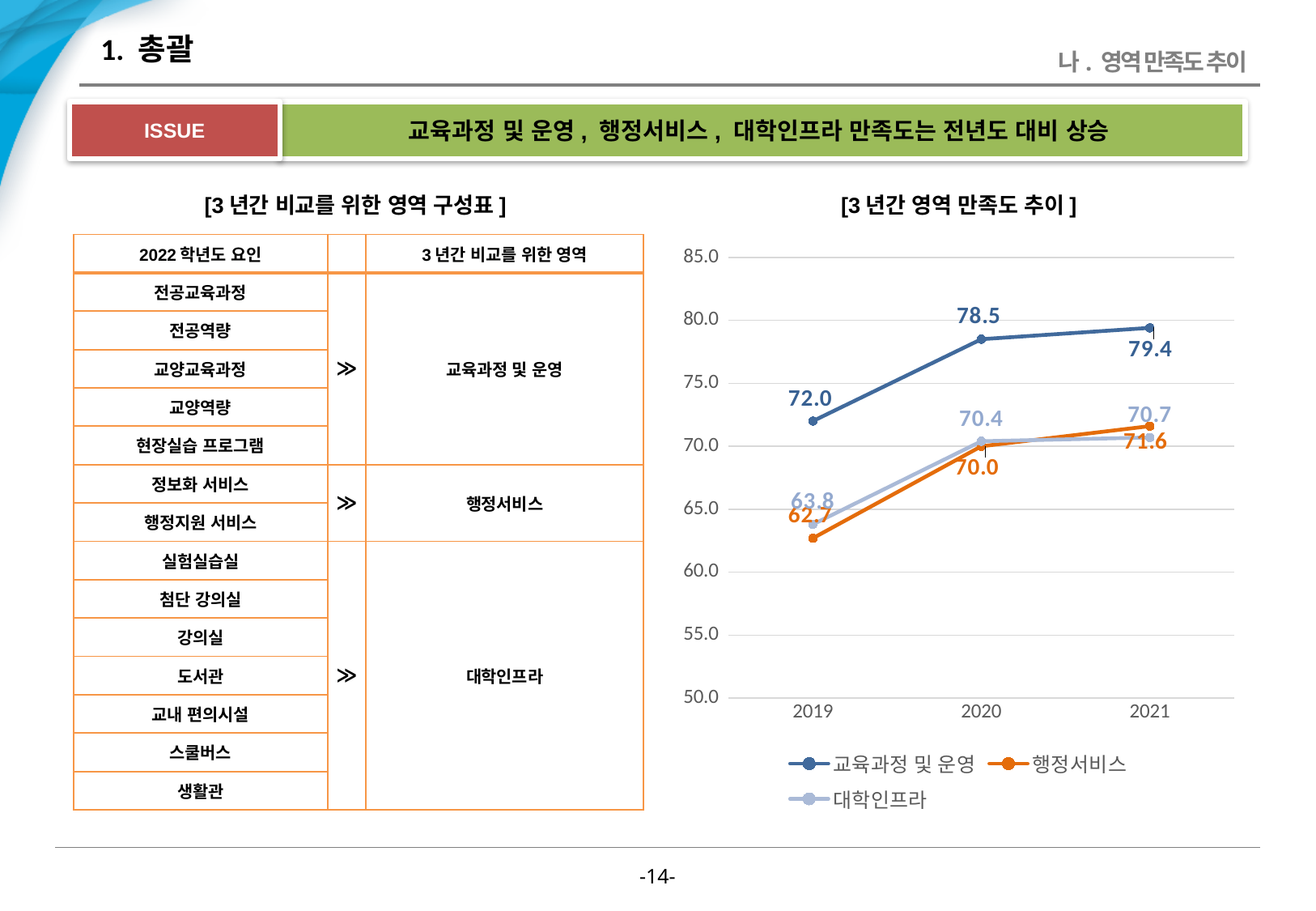
What is the value for 행정서비스 in 2019? 62.7 Which series has the highest value in 2021? 교육과정 및 운영 What type of chart is shown on the slide? line chart What is the title of the chart? [3 년간 영역 만족도 추이 ] Does the 행정서비스 line rise or fall from 2019 to 2021? rise How many series does the chart legend list? 3 How many years are shown on the x axis of the chart? 3 What is the value for 교육과정 및 운영 in 2021? 79.4 What is the difference between the 교육과정 및 운영 values for 2021 and 2019? 7.4 What is the value for 교육과정 및 운영 in 2020? 78.5 Which series has the lowest value in 2019? 행정서비스 What is the value for 대학인프라 in 2020? 70.4